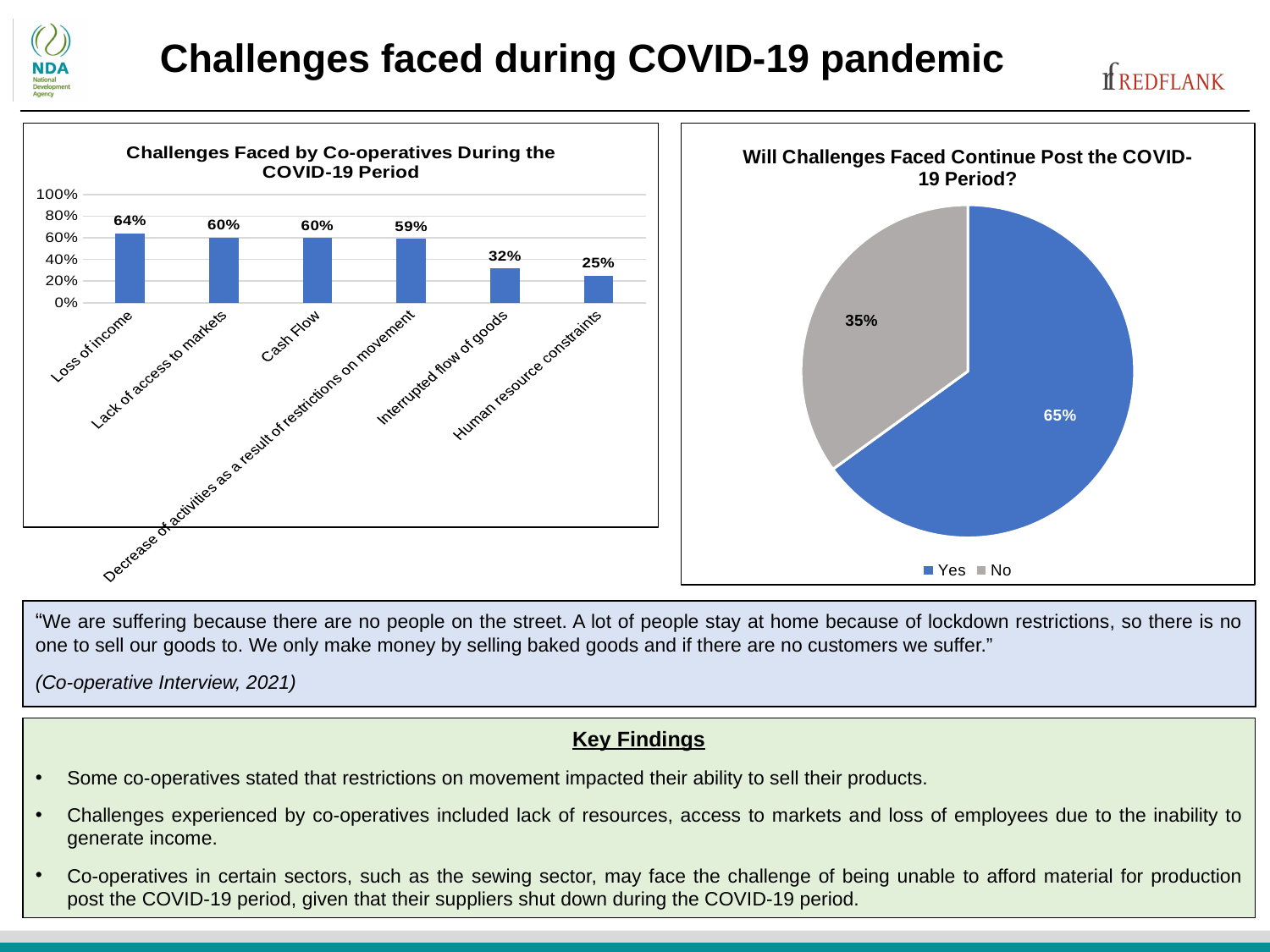
In the 'Challenges Faced by Co-operatives During the COVID-19 Period' chart, which category has the highest value? Loss of income In the 'Challenges Faced by Co-operatives During the COVID-19 Period' chart, what is the difference between Loss of income and Interrupted flow of goods? 32% In the 'Challenges Faced by Co-operatives During the COVID-19 Period' chart, what is the value for Loss of income? 64% In the 'Challenges Faced by Co-operatives During the COVID-19 Period' chart, what is the value for Human resource constraints? 25% In the 'Challenges Faced by Co-operatives During the COVID-19 Period' chart, which category has the lowest value? Human resource constraints In the 'Challenges Faced by Co-operatives During the COVID-19 Period' chart, how many categories are shown? 6 In the 'Challenges Faced by Co-operatives During the COVID-19 Period' chart, which is larger: Interrupted flow of goods or Human resource constraints? Interrupted flow of goods What kind of chart is 'Challenges Faced by Co-operatives During the COVID-19 Period'? Bar chart How many entries does the legend of the 'Will Challenges Faced Continue Post the COVID-19 Period?' chart list? 2 In the 'Will Challenges Faced Continue Post the COVID-19 Period?' chart, what share of respondents answered No? 35% In the 'Challenges Faced by Co-operatives During the COVID-19 Period' chart, do the values rise or fall from left to right? Fall In the 'Will Challenges Faced Continue Post the COVID-19 Period?' chart, what share of respondents answered Yes? 65%